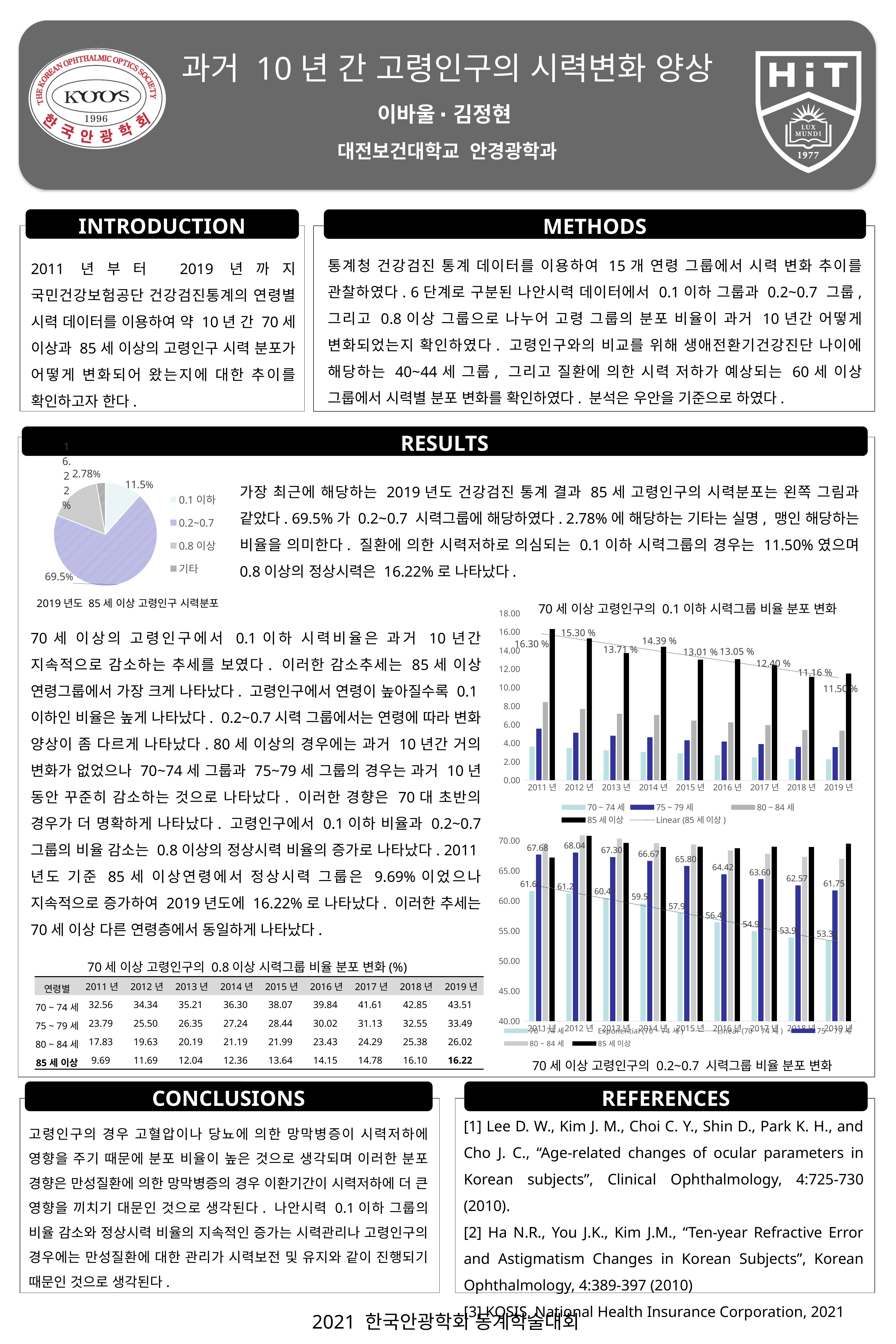
How many entries does the legend of the pie chart titled 2019년도 85세 이상 고령인구 시력분포 list? 4 In the chart titled 70세 이상 고령인구의 0.1 이하 시력그룹 비율 분포 변화, what is the difference between the 85세 이상 values for 2011년 and 2019년? 4.80 % In the chart titled 70세 이상 고령인구의 0.1 이하 시력그룹 비율 분포 변화, how many years are shown on the x axis? 9 In the chart titled 70세 이상 고령인구의 0.2~0.7 시력그룹 비율 분포 변화, what is the value for 75~79세 in 2019년? 61.75 What kind of chart is the chart titled 70세 이상 고령인구의 0.1 이하 시력그룹 비율 분포 변화? bar chart In the chart titled 70세 이상 고령인구의 0.1 이하 시력그룹 비율 분포 변화, is the value for 70~74세 in 2011년 greater or less than 4.00? less In the pie chart titled 2019년도 85세 이상 고령인구 시력분포, what is the value of the 기타 slice? 2.78% In the chart titled 70세 이상 고령인구의 0.1 이하 시력그룹 비율 분포 변화, in which year is the 85세 이상 value lowest? 2018년 In the chart titled 70세 이상 고령인구의 0.1 이하 시력그룹 비율 분포 변화, what is the value for 85세 이상 in 2011년? 16.30 % In the chart titled 70세 이상 고령인구의 0.2~0.7 시력그룹 비율 분포 변화, do the 70~74세 values rise or fall from 2011년 to 2019년? fall In the pie chart titled 2019년도 85세 이상 고령인구 시력분포, what share does the 0.2~0.7 slice have? 69.5% In the pie chart titled 2019년도 85세 이상 고령인구 시력분포, which slice is the largest? 0.2~0.7